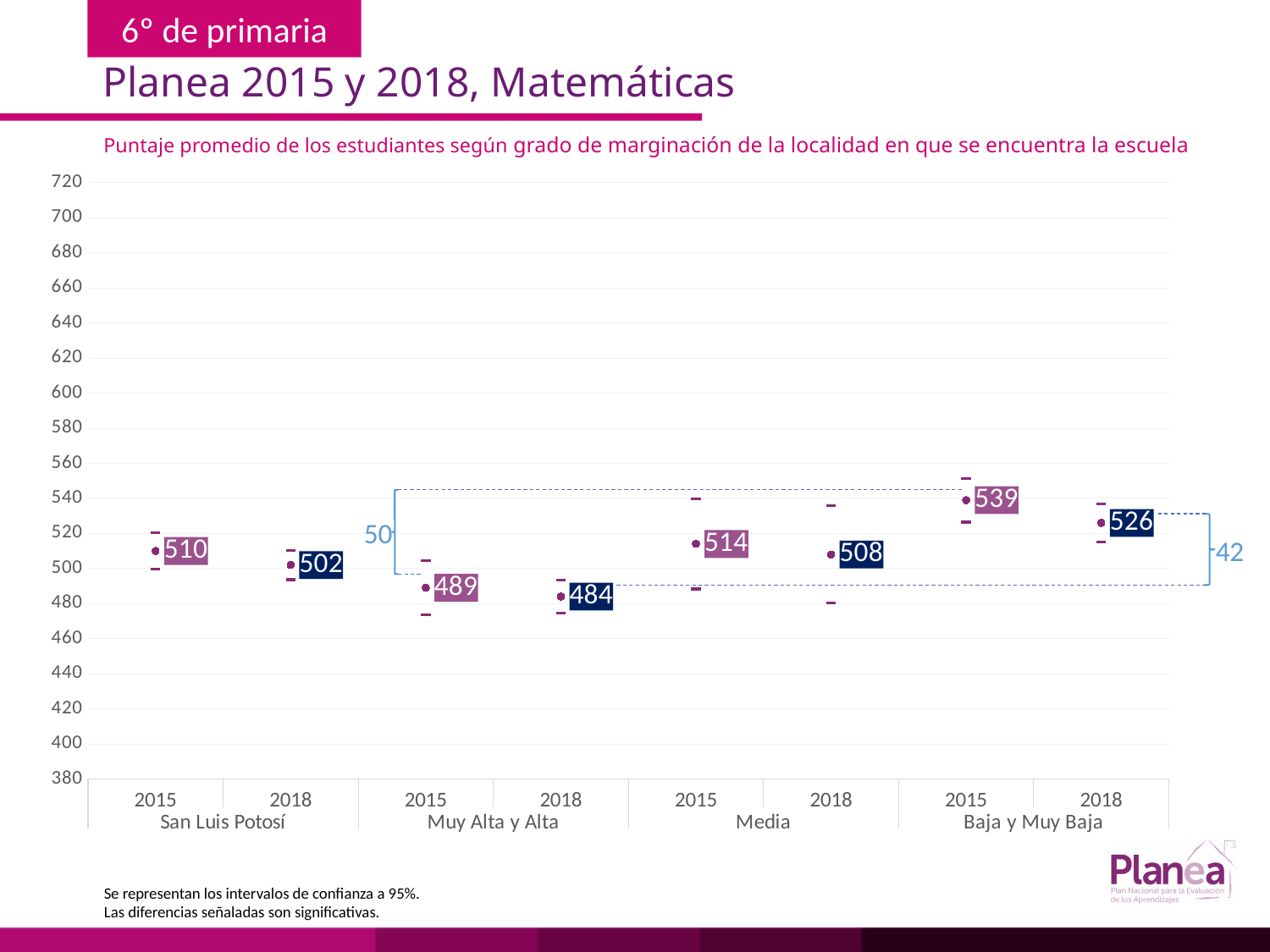
Which is larger, the 2018 score for Media or the 2018 score for San Luis Potosí? Media (508) What is the average score for San Luis Potosí in 2015? 510 Did the average score for each group rise or fall from 2015 to 2018? Fall How many data points are plotted on the chart? 8 Which group and year has the lowest average score? Muy Alta y Alta, 2018 (484) What is the average score for the Baja y Muy Baja group in 2018? 526 What do the short horizontal lines above and below each point represent? 95% confidence intervals Which group and year has the highest average score? Baja y Muy Baja, 2015 (539) By how much did the San Luis Potosí average score change from 2015 to 2018? 8 points lower (510 to 502) What is the average score for the Media group in 2015? 514 What is the average score for the Muy Alta y Alta marginación group in 2018? 484 What is the difference between the 2015 scores of the Baja y Muy Baja group and the Muy Alta y Alta group? 50